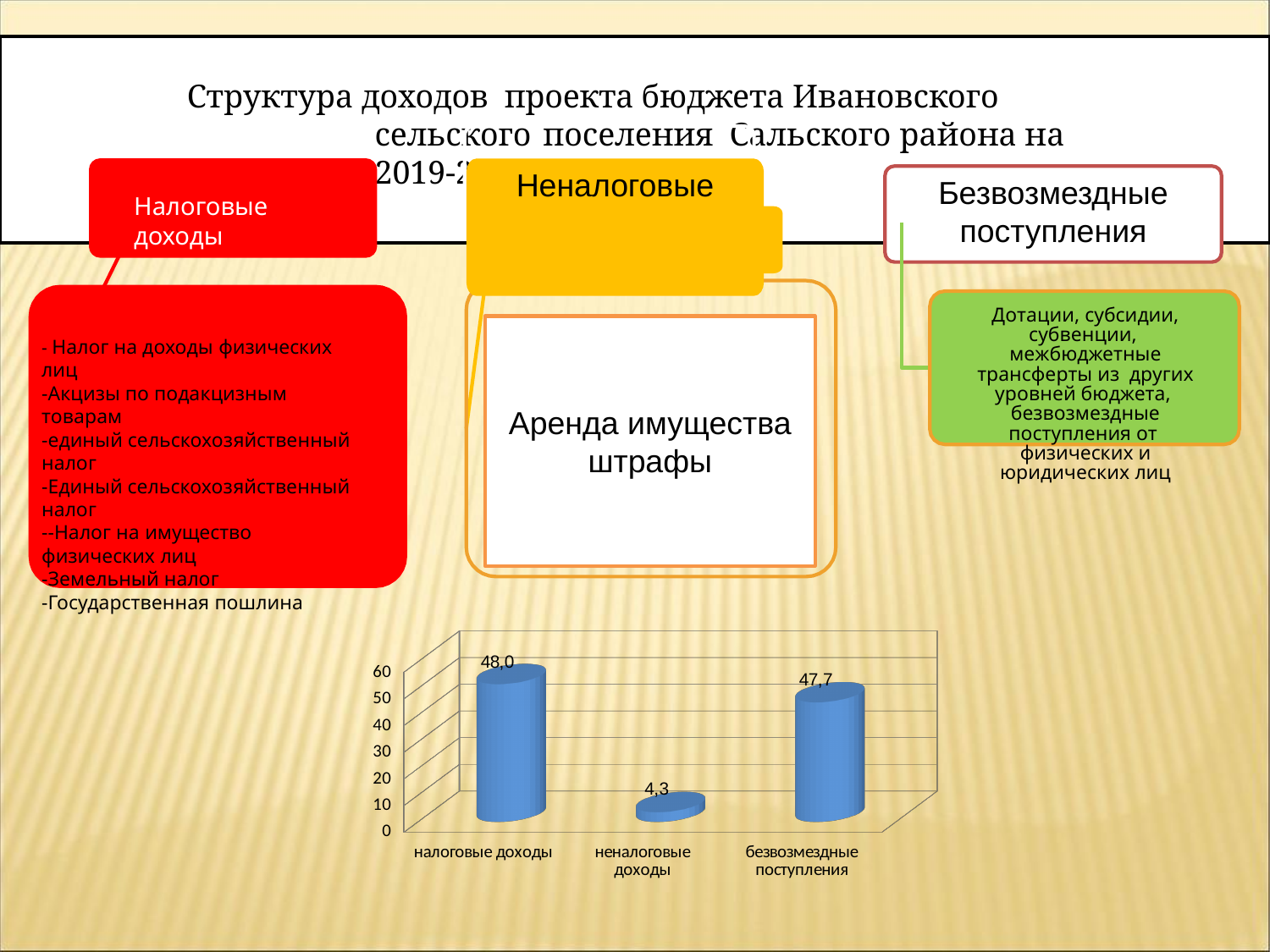
Is the value for неналоговые доходы greater or less than 10? less What kind of chart is shown on the slide? bar chart How many categories are shown on the x axis of the chart? 3 What is the value for налоговые доходы? 48,0 What is the highest value shown on the vertical axis of the chart? 60 Which is larger, the value for налоговые доходы or the value for неналоговые доходы? налоговые доходы What is the difference between the values for безвозмездные поступления and неналоговые доходы? 43,4 Is the value for безвозмездные поступления greater or less than 40? greater Which category has the lowest value? неналоговые доходы What is the difference between the values for налоговые доходы and неналоговые доходы? 43,7 What is the value for неналоговые доходы? 4,3 What is the value for безвозмездные поступления? 47,7